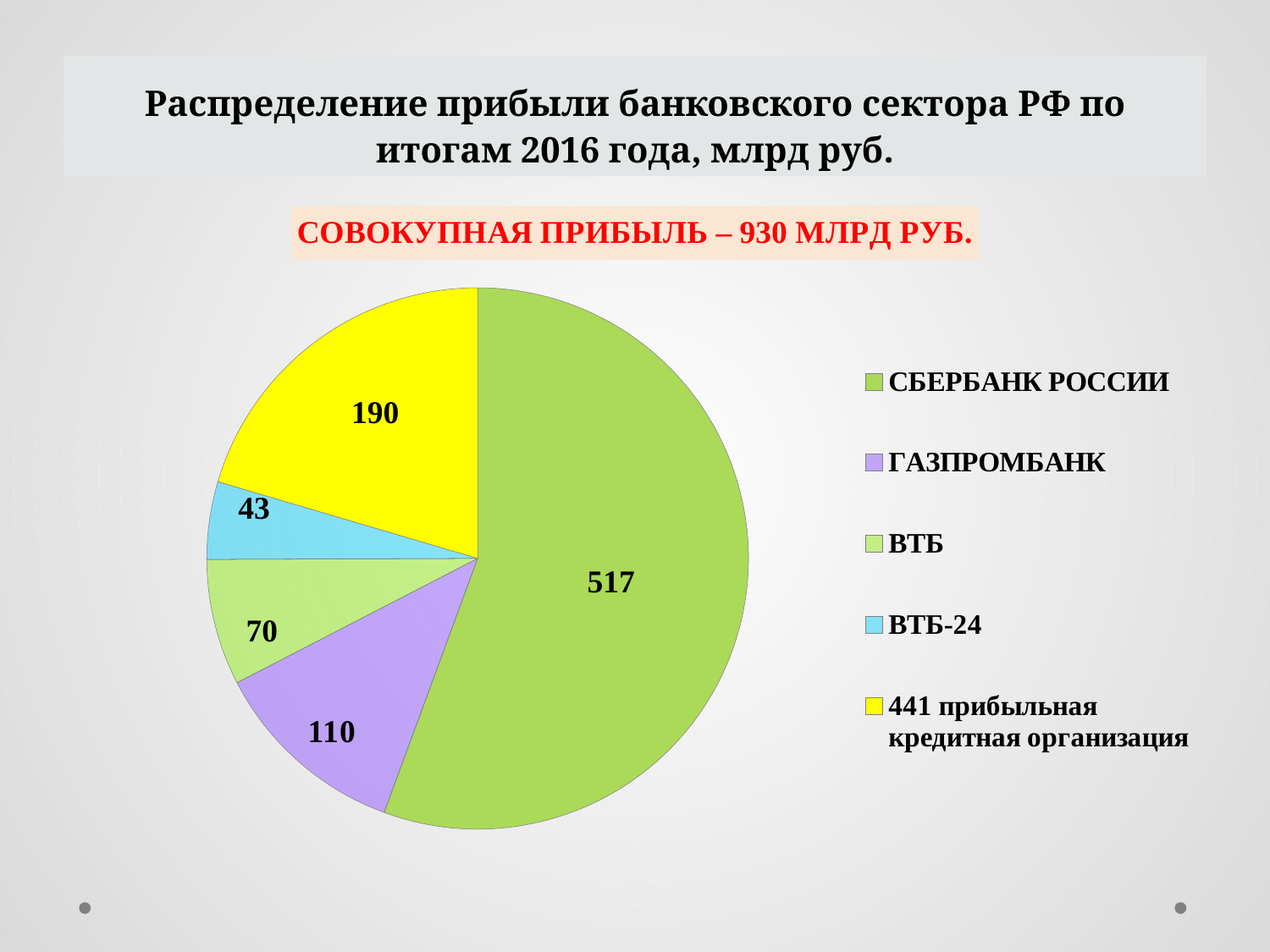
What is the value for ВТБ-24? 43 Which category has the smallest slice of the pie? ВТБ-24 What kind of chart is shown on the slide? pie chart What is the difference between the values for ГАЗПРОМБАНК and ВТБ? 40 How many slices does the pie chart have? 5 What share of the total does СБЕРБАНК РОССИИ account for? 55.6% Which is larger, the value for ВТБ or the value for ВТБ-24? ВТБ What is the value for the slice labelled 441 прибыльная кредитная организация? 190 What colour is the slice for ГАЗПРОМБАНК? purple Which category has the largest slice of the pie? СБЕРБАНК РОССИИ What is the value for ГАЗПРОМБАНК? 110 What is the value for СБЕРБАНК РОССИИ? 517